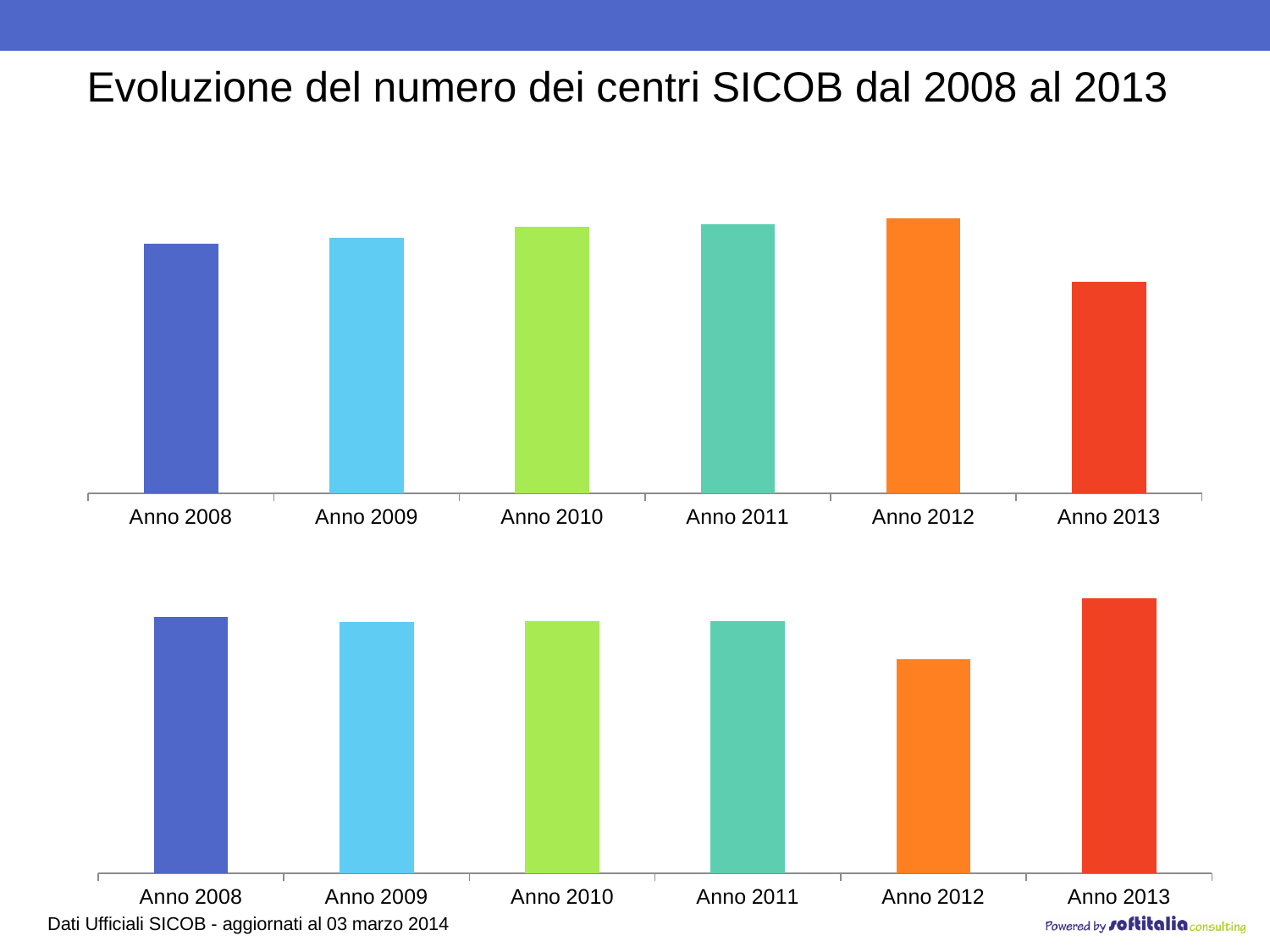
In the top chart, is the bar for Anno 2012 taller or shorter than the bar for Anno 2013? taller What kind of chart is the bottom chart on the slide? bar chart What is the title shown above the charts on the slide? Evoluzione del numero dei centri SICOB dal 2008 al 2013 What kind of chart is the top chart on the slide? bar chart In the bottom chart, which year has the tallest bar? Anno 2013 How many bars does the top chart have? 6 In the bottom chart, is the bar for Anno 2012 taller or shorter than the bar for Anno 2013? shorter In the top chart, do the bars rise or fall from Anno 2008 to Anno 2012? rise In the top chart, which year has the shortest bar? Anno 2013 How many categories are shown on the x axis of the bottom chart? 6 In the top chart, which year has the tallest bar? Anno 2012 In the bottom chart, which year has the shortest bar? Anno 2012